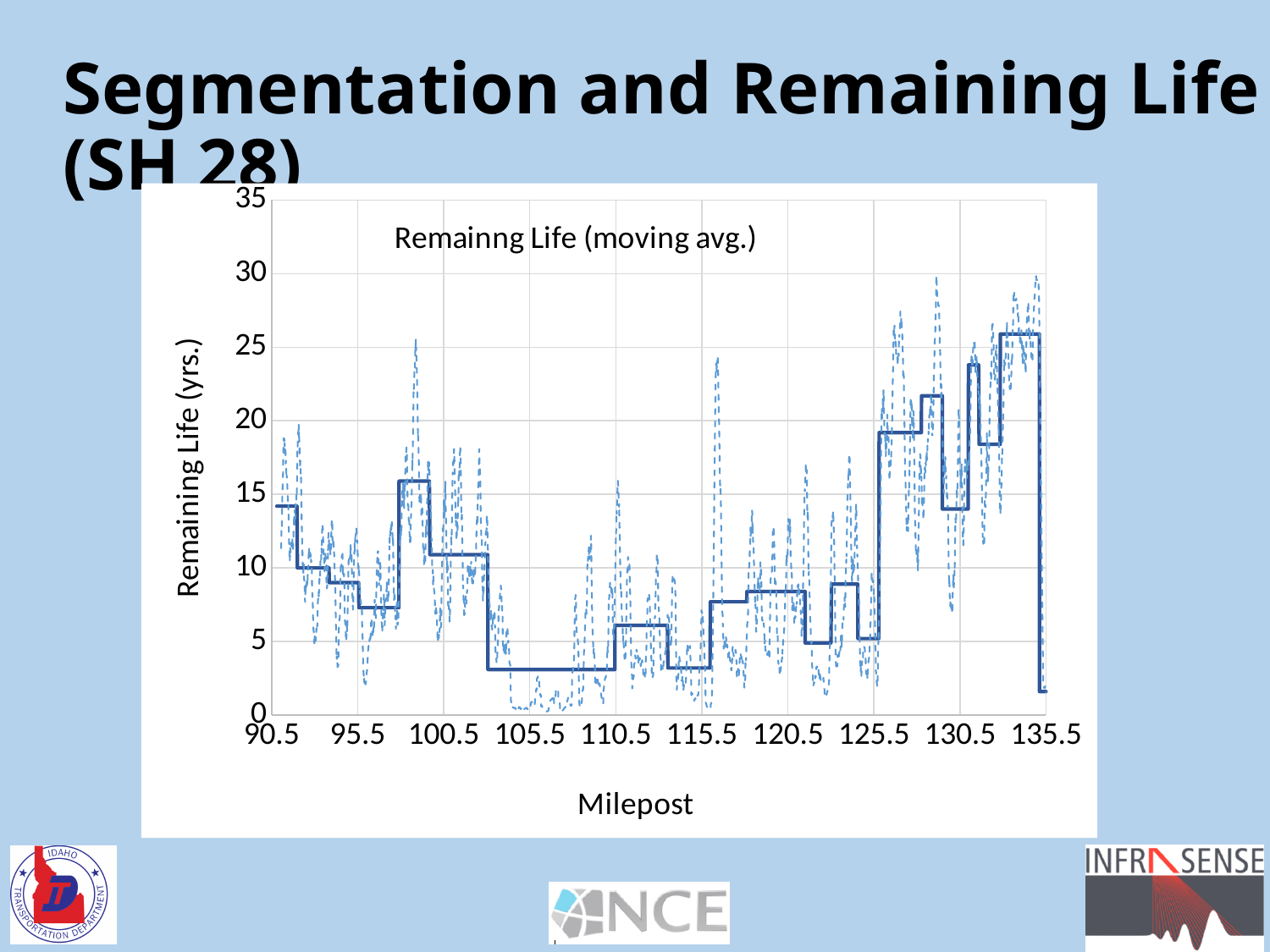
What is the highest value shown on the y axis? 35 What kind of chart is shown on the slide? line chart Between milepost 125.5 and milepost 135, are the values of the solid step line generally higher or lower than between milepost 105.5 and milepost 115.5? higher What is the last milepost tick shown on the x axis? 135.5 What is the title printed inside the chart? Remainng Life (moving avg.) Is the value of the solid step line at milepost 127 greater or less than 15? greater Which is larger on the solid step line: the value at milepost 107 or the value at milepost 134? milepost 134 Is the value of the solid step line at milepost 107 greater or less than 5? less Is the value of the solid step line at milepost 91 greater or less than 10? greater What is the label of the x axis? Milepost How many tick labels are shown on the x axis? 10